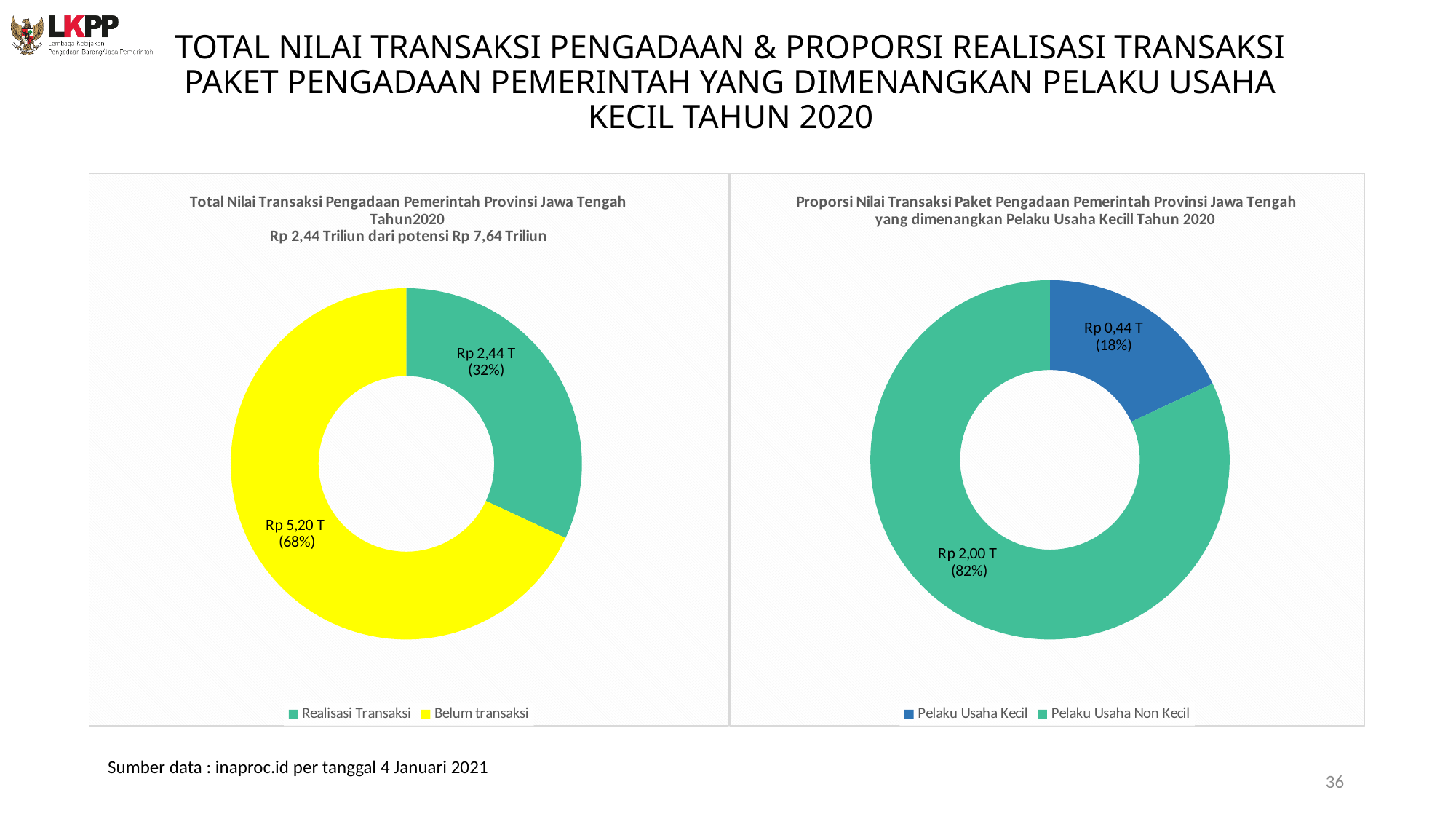
In the right chart, what is the value for Pelaku Usaha Kecil? Rp 0,44 T What kind of chart is the left chart? Donut (pie) chart In the left chart, which category is the largest? Belum transaksi In the left chart, which colour represents Belum transaksi? Yellow In the right chart, what is the value for Pelaku Usaha Non Kecil? Rp 2,00 T In the left chart, what is the value for Realisasi Transaksi? Rp 2,44 T How many categories does the legend of the right chart list? 2 In the right chart, which category is the smallest? Pelaku Usaha Kecil In the right chart, which is larger, Pelaku Usaha Kecil or Pelaku Usaha Non Kecil? Pelaku Usaha Non Kecil In the left chart, what is the value for Belum transaksi? Rp 5,20 T In the left chart, what share of the total does Belum transaksi represent? 68% In the right chart, what share of the total does Pelaku Usaha Kecil represent? 18%